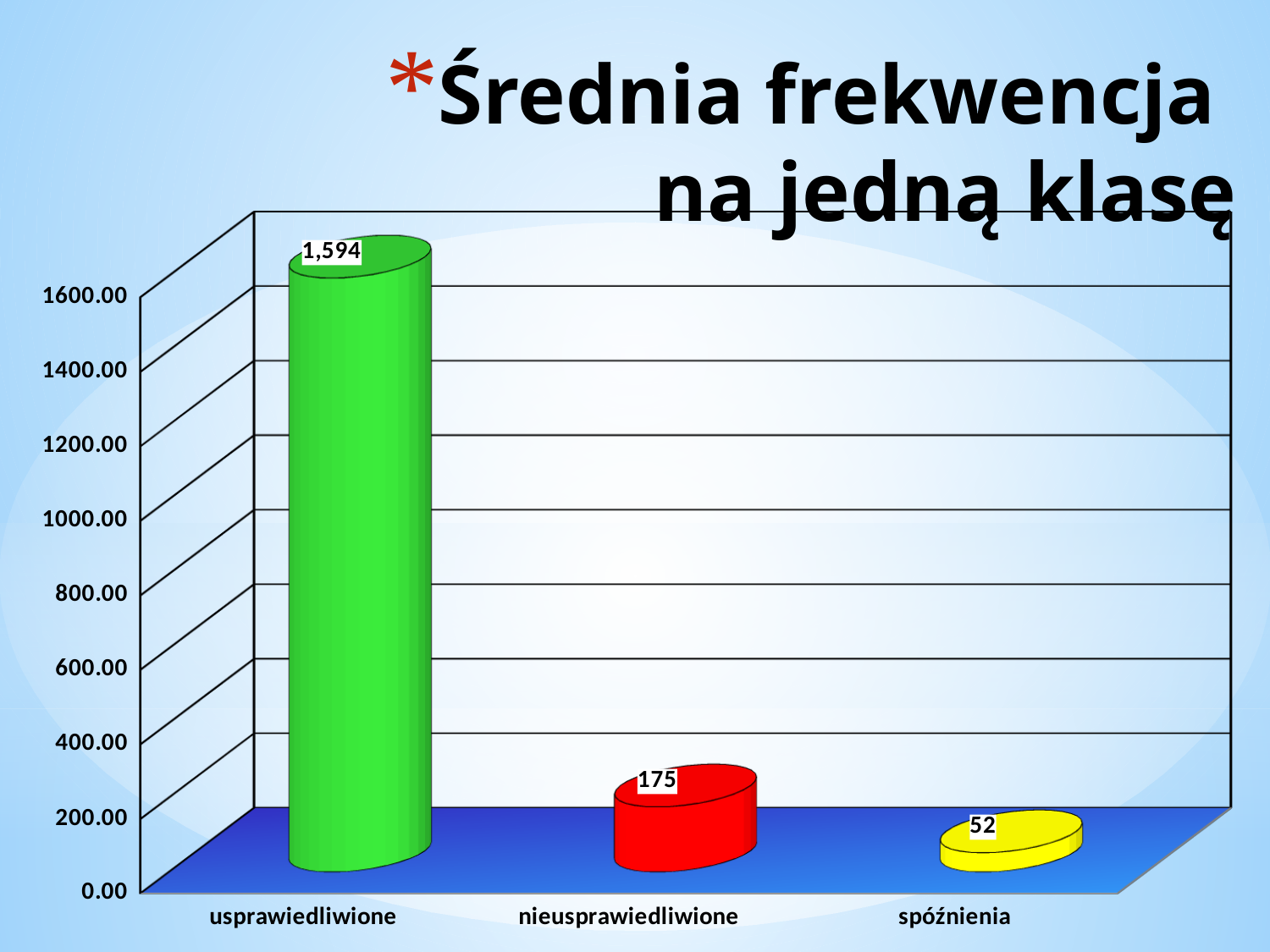
What is the difference between the values for usprawiedliwione and nieusprawiedliwione? 1,419 Is the value for usprawiedliwione greater or less than 1400? greater Which category has the highest value? usprawiedliwione How many categories are shown on the chart? 3 What is the value for usprawiedliwione? 1,594 What kind of chart is shown on the slide? bar chart Which category has the lowest value? spóźnienia Which is larger, the value for nieusprawiedliwione or the value for spóźnienia? nieusprawiedliwione What is the title of the slide? Średnia frekwencja na jedną klasę What is the value for spóźnienia? 52 What is the difference between the values for nieusprawiedliwione and spóźnienia? 123 What is the value for nieusprawiedliwione? 175